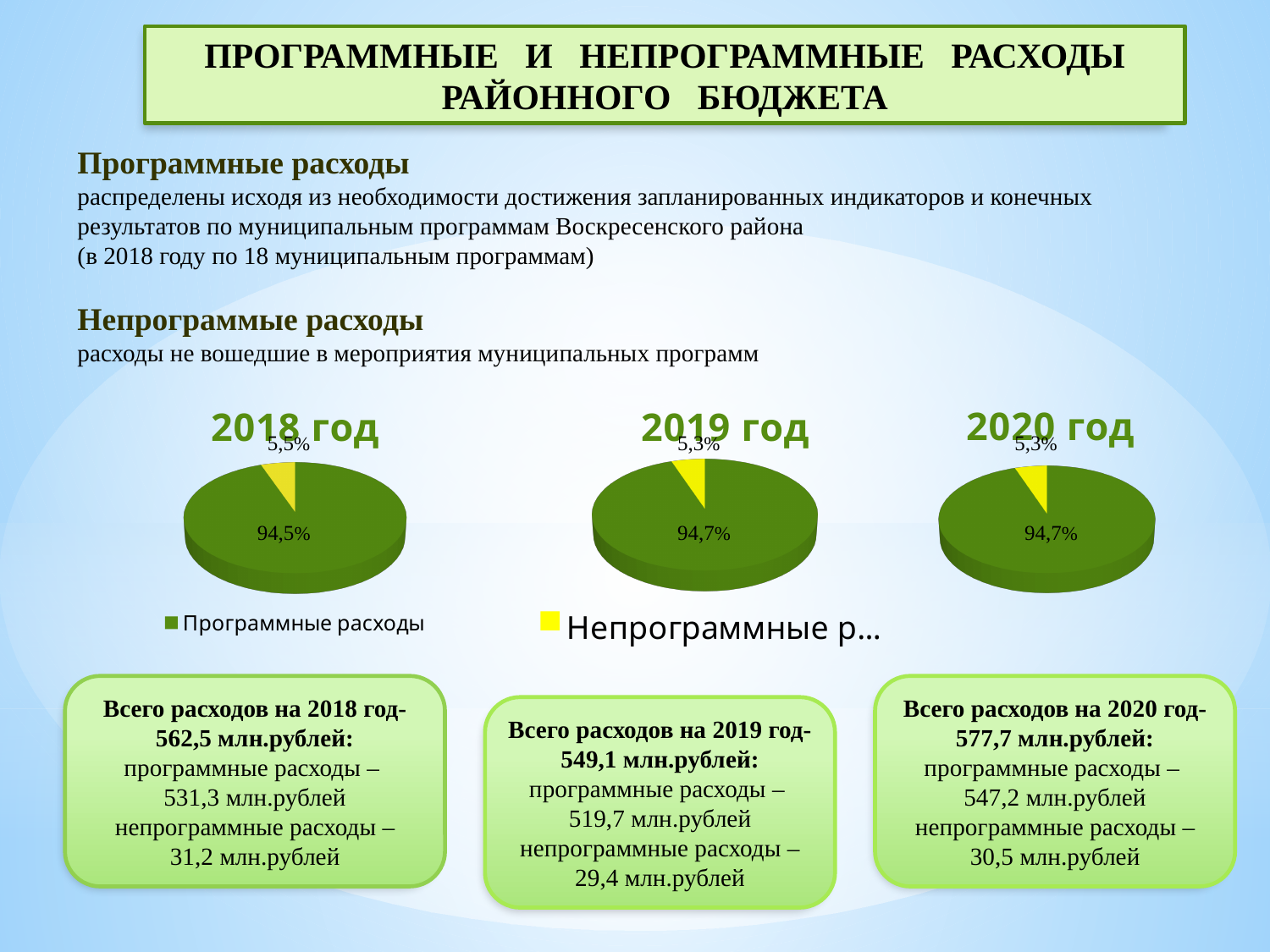
How many series does the legend below the pie charts list? 2 What colour represents Программные расходы in the pie charts? Green In the 2020 год pie chart, what share is shown for Непрограммные расходы? 5,3% In the 2019 год pie chart, what share is shown for Программные расходы? 94,7% In the 2019 год pie chart, which is larger: Программные расходы or Непрограммные расходы? Программные расходы What kind of chart is used for 2018 год, 2019 год and 2020 год? Pie chart In the 2018 год pie chart, what is the difference between the Программные расходы share and the Непрограммные расходы share? 89 percentage points How many slices does the 2019 год pie chart have? 2 In the 2018 год pie chart, what share is shown for Непрограммные расходы? 5,5% In the 2020 год pie chart, which slice is the smallest? Непрограммные расходы In the 2018 год pie chart, what share is shown for Программные расходы? 94,5% In the 2018 год pie chart, which slice is the largest? Программные расходы